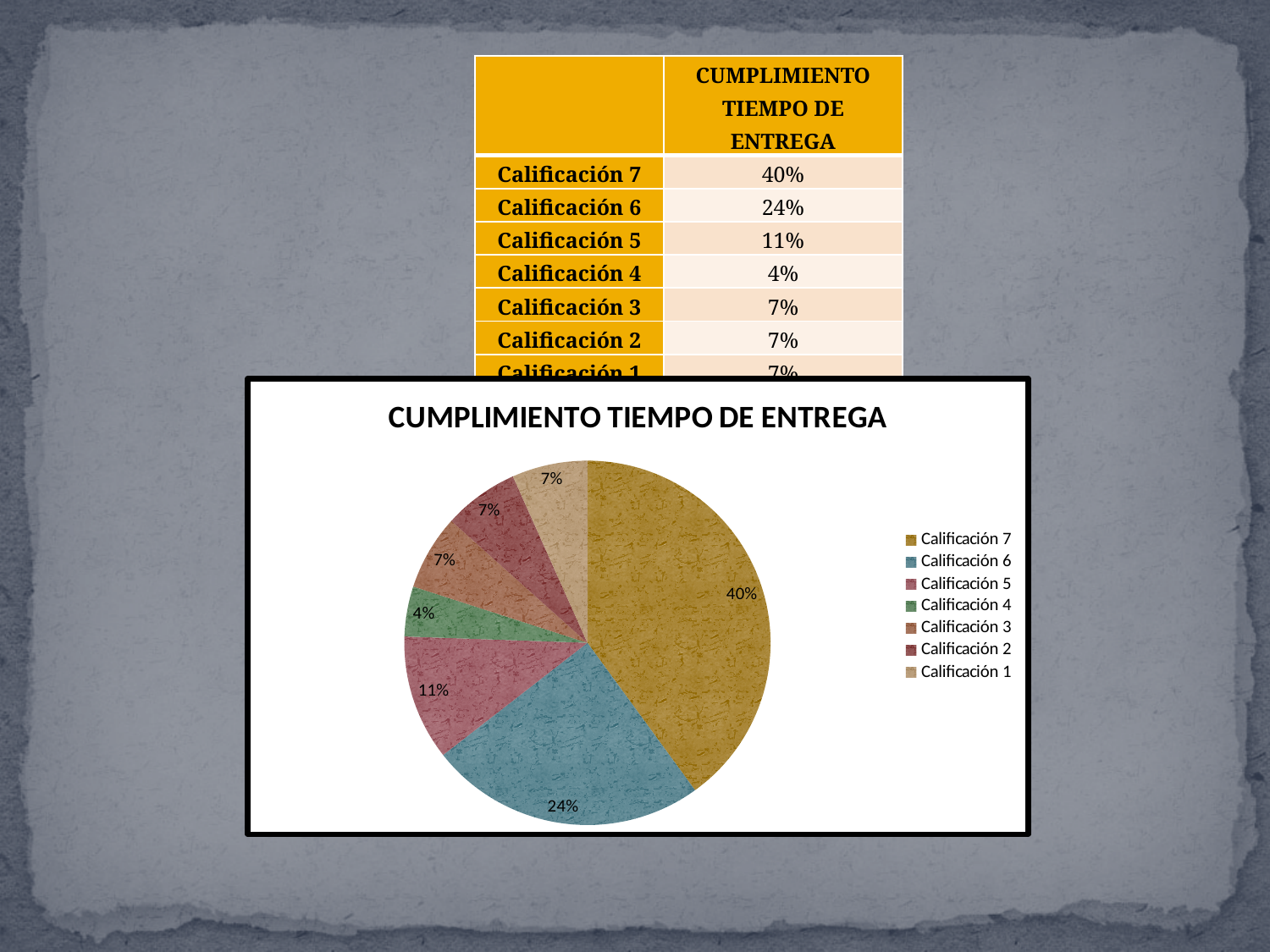
What is the combined share of Calificación 7 and Calificación 6? 64% How many categories does the legend list? 7 What type of chart is shown on the slide? pie chart What share of the pie does Calificación 7 represent? 40% What is the value shown for Calificación 5? 11% What is the value shown for Calificación 6? 24% What is the title of the chart? CUMPLIMIENTO TIEMPO DE ENTREGA What is the value shown for Calificación 4? 4% What is the difference between the values for Calificación 7 and Calificación 6? 16% Which is larger, the value for Calificación 5 or the value for Calificación 4? Calificación 5 Which category has the smallest slice of the pie? Calificación 4 Which category has the largest slice of the pie? Calificación 7